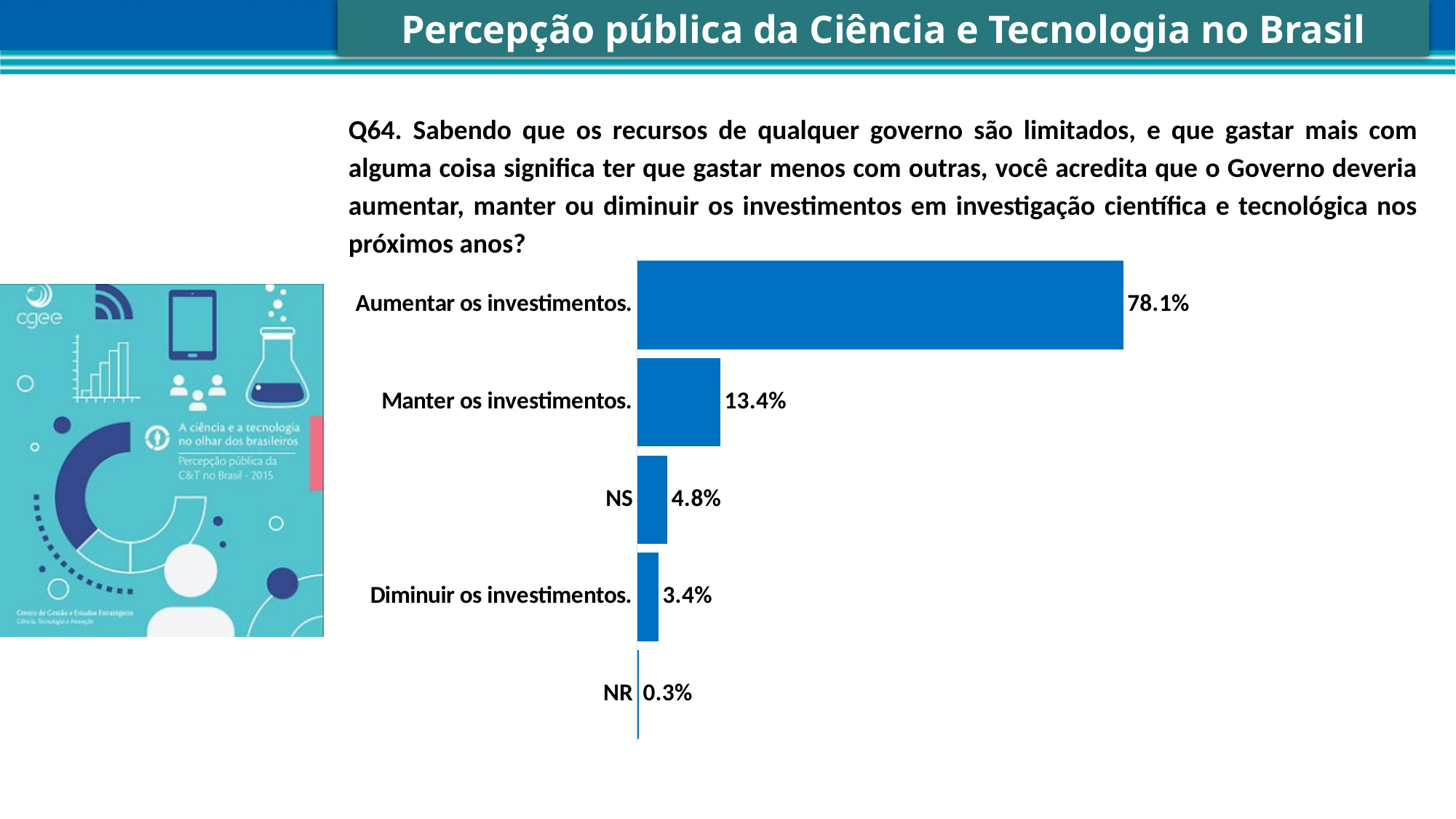
What is the difference between "Aumentar os investimentos." and "Manter os investimentos."? 64.7% What kind of chart is shown on the slide? Bar chart What is the value for NR? 0.3% What is the value for NS? 4.8% What is the value for "Diminuir os investimentos."? 3.4% What is the difference between NS and "Diminuir os investimentos."? 1.4% How many categories are shown in the chart? 5 Which category has the lowest value? NR What is the value for "Manter os investimentos."? 13.4% What is the value for "Aumentar os investimentos."? 78.1% Which is larger, "Manter os investimentos." or NS? Manter os investimentos. Which category has the highest value? Aumentar os investimentos.